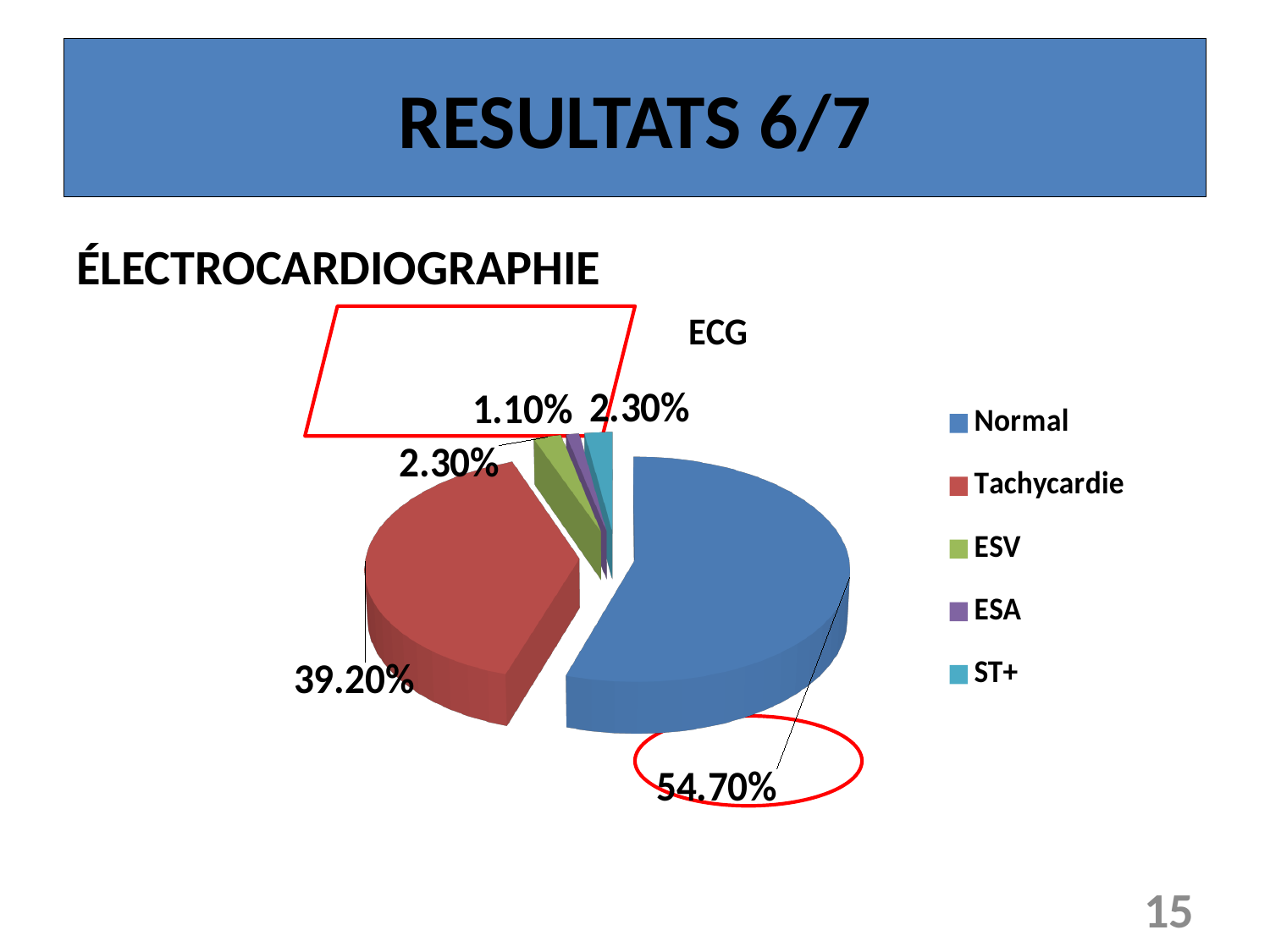
Which category has the smallest share of the ECG pie chart? ESA How many categories does the legend of the ECG chart list? 5 What percentage of the ECG pie chart is ESA? 1.10% What is the combined share of Normal and Tachycardie in the ECG chart? 93.90% What is the difference between the Normal and Tachycardie shares in the ECG chart? 15.50% Which is larger in the ECG chart, the Tachycardie share or the ESV share? Tachycardie What percentage of the ECG pie chart is Normal? 54.70% What is the title of the chart? ECG Which category has the largest share of the ECG pie chart? Normal What percentage of the ECG pie chart is Tachycardie? 39.20% What type of chart is shown on the slide? pie chart What colour represents Tachycardie in the ECG chart? red